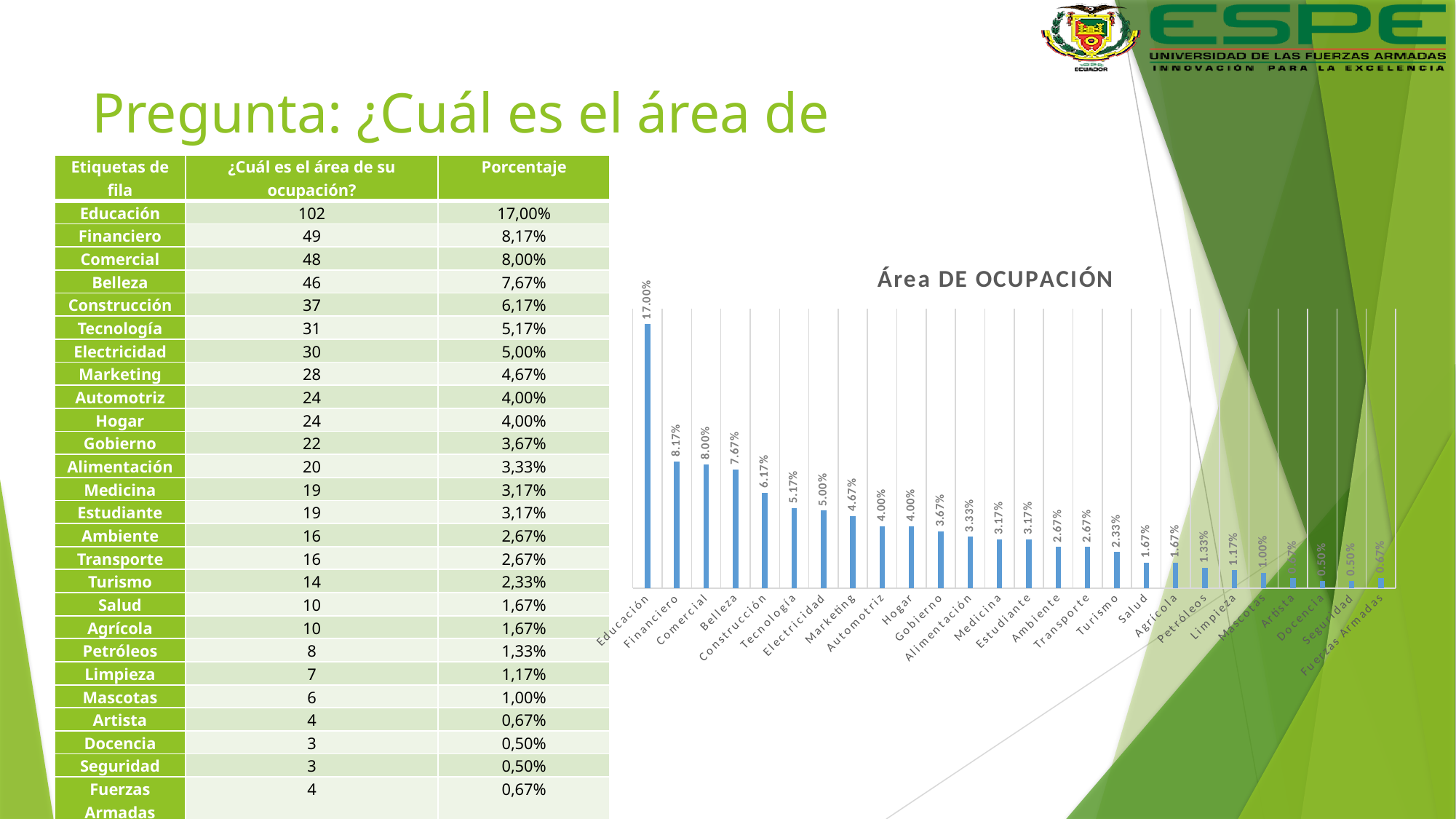
Do the values in the chart rise or fall from left to right along the x axis? fall What kind of chart is shown on the slide? bar chart How many categories are plotted in the chart? 26 Which category has the highest value in the chart? Educación What is the value shown for Construcción in the chart? 6.17% What is the title of the chart? Área DE OCUPACIÓN What colour are the bars in the chart? blue What is the difference between the values for Educación and Financiero in the chart? 8.83% Which is larger in the chart, Tecnología or Marketing? Tecnología What is the value shown for Turismo in the chart? 2.33% What is the value shown for Petróleos in the chart? 1.33% What is the value shown for Educación in the chart? 17.00%